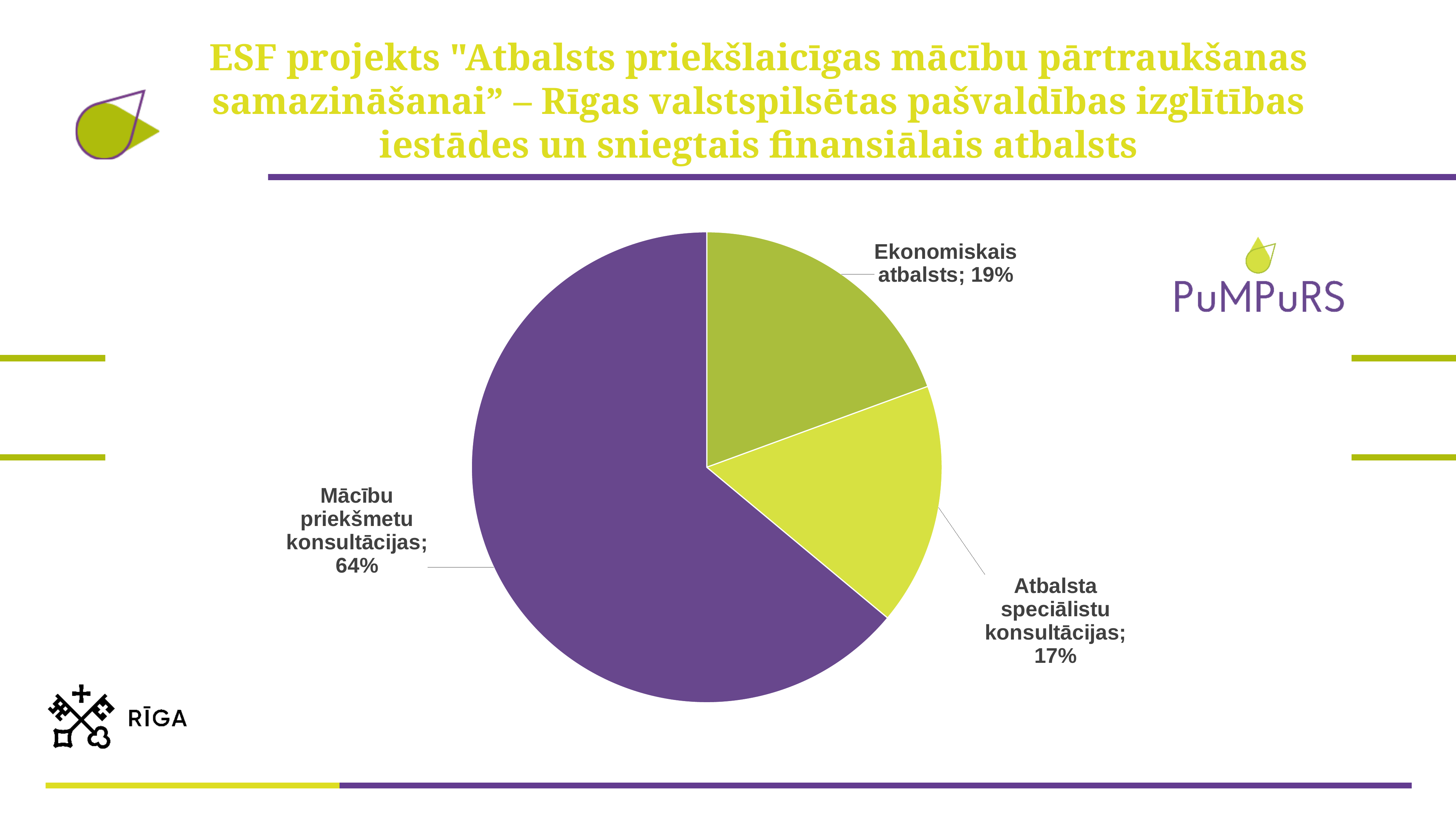
What share of the pie does "Ekonomiskais atbalsts" represent? 19% What share of the pie does "Atbalsta speciālistu konsultācijas" represent? 17% How many slices does the pie chart have? 3 What is the difference in percentage points between "Ekonomiskais atbalsts" and "Atbalsta speciālistu konsultācijas"? 2 Which is larger: the slice for "Ekonomiskais atbalsts" or the slice for "Atbalsta speciālistu konsultācijas"? Ekonomiskais atbalsts What share of the pie does "Mācību priekšmetu konsultācijas" represent? 64% What kind of chart is shown on the slide? pie chart Which category has the largest slice of the pie? Mācību priekšmetu konsultācijas What is the combined share of "Ekonomiskais atbalsts" and "Atbalsta speciālistu konsultācijas"? 36% What colour is the slice for "Mācību priekšmetu konsultācijas"? purple What is the difference in percentage points between "Mācību priekšmetu konsultācijas" and "Ekonomiskais atbalsts"? 45 Which category has the smallest slice of the pie? Atbalsta speciālistu konsultācijas